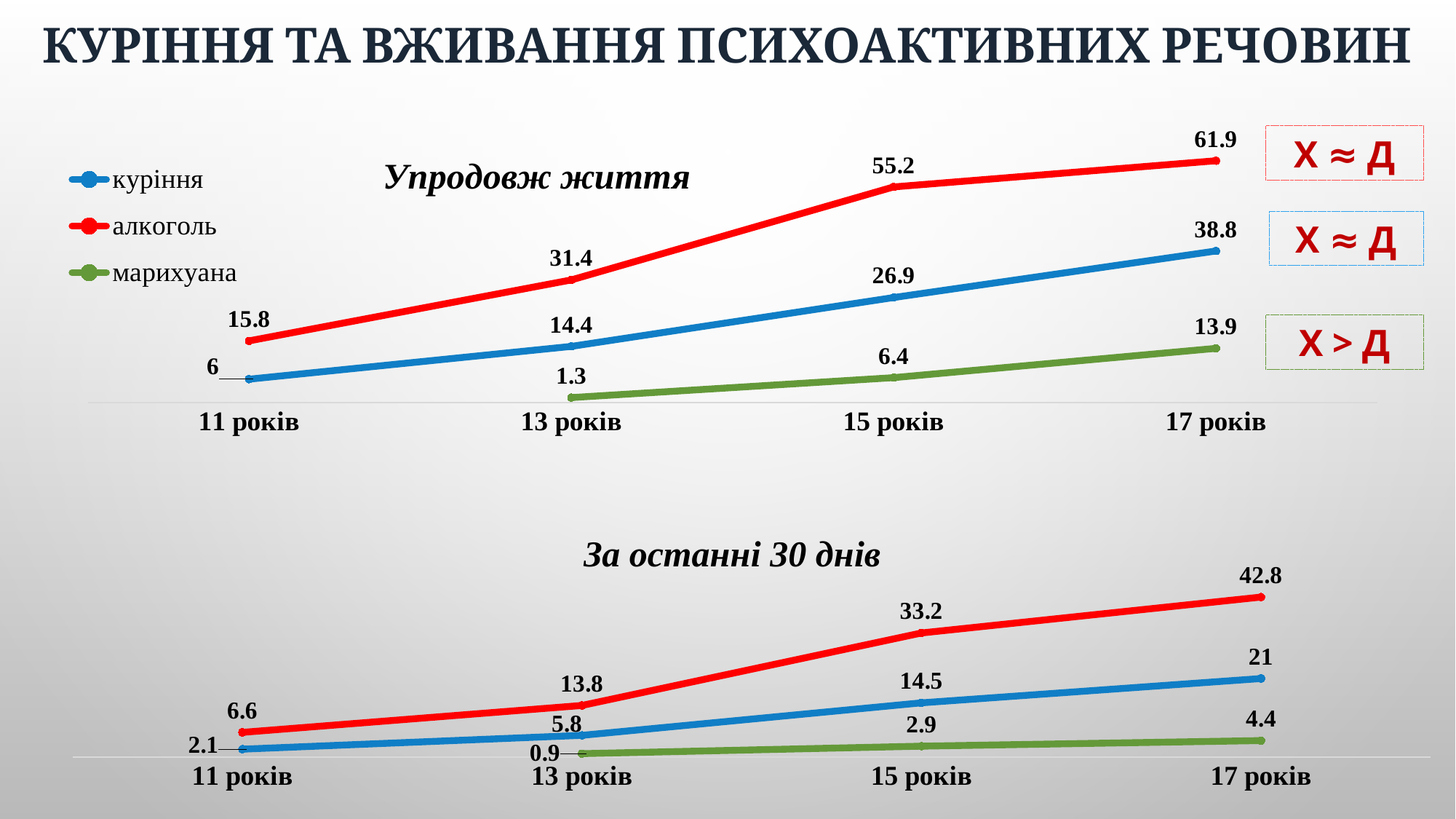
In the chart titled "За останні 30 днів", what is the value for алкоголь at 11 років? 6.6 In the chart titled "Упродовж життя", which is larger at 15 років: куріння or марихуана? куріння In the chart titled "За останні 30 днів", what is the value for марихуана at 15 років? 2.9 In the chart titled "Упродовж життя", at which age group is the value for куріння highest? 17 років How many series does the legend list? 3 In the chart titled "За останні 30 днів", at which age group is the value for марихуана lowest? 13 років In the chart titled "Упродовж життя", what is the value for алкоголь at 17 років? 61.9 In the chart titled "Упродовж життя", what is the value for куріння at 13 років? 14.4 What kind of chart is the chart titled "За останні 30 днів"? line chart In the chart titled "Упродовж життя", what is the difference between the алкоголь values at 15 років and 13 років? 23.8 In the chart titled "За останні 30 днів", what is the difference between the алкоголь and куріння values at 17 років? 21.8 In the chart titled "За останні 30 днів", do the values for куріння rise or fall from 11 років to 17 років? rise